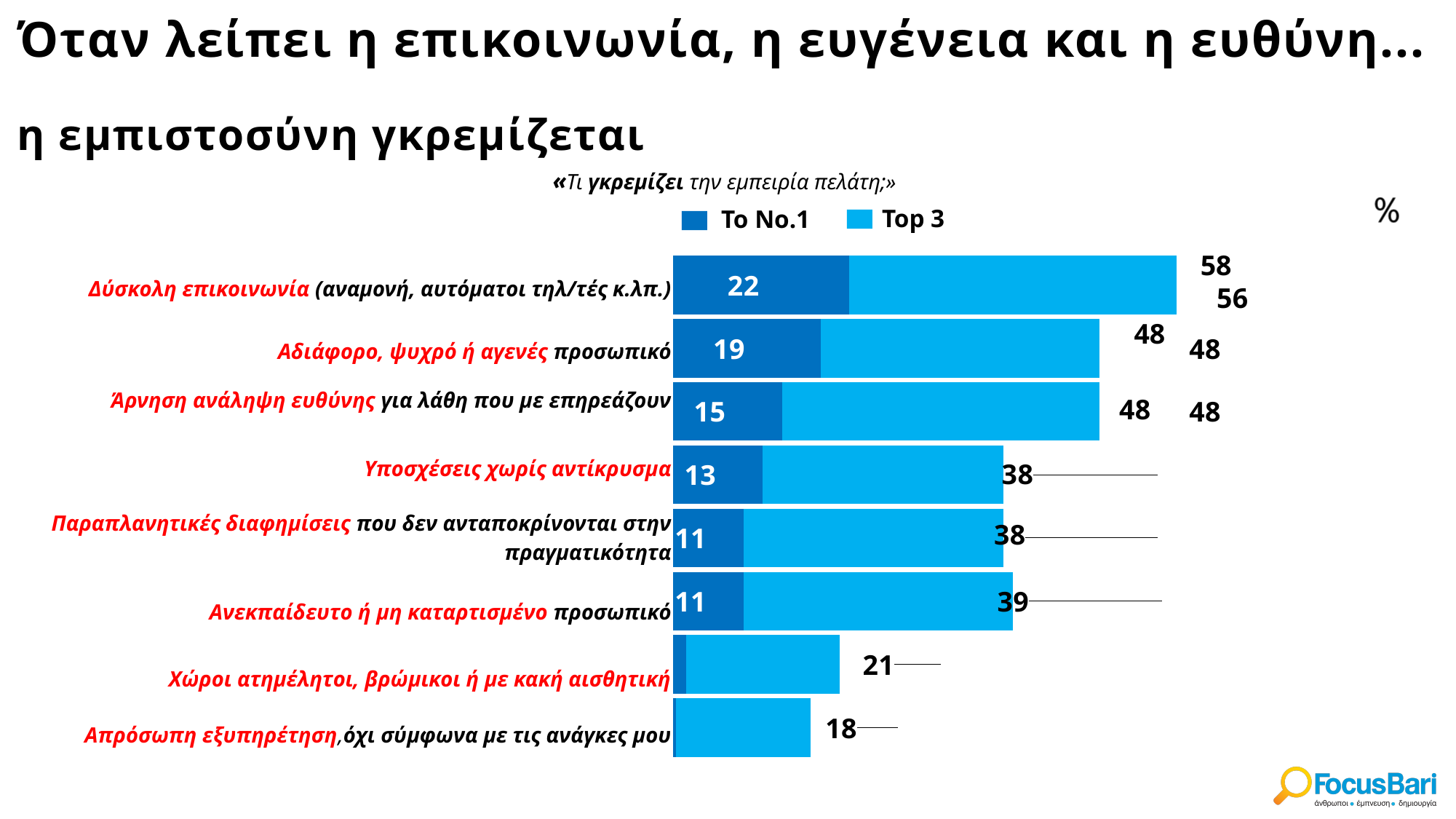
What is the 'Το No.1' value for 'Δύσκολη επικοινωνία'? 22 How many categories are plotted in the chart? 8 What kind of chart is shown on the slide? bar chart What is the 'Top 3' value for 'Ανεκπαίδευτο ή μη καταρτισμένο προσωπικό'? 39 How many series does the legend list? 2 What is the 'Top 3' value for 'Απρόσωπη εξυπηρέτηση, όχι σύμφωνα με τις ανάγκες μου'? 18 What is the 'Το No.1' value for 'Άρνηση ανάληψη ευθύνης για λάθη που με επηρεάζουν'? 15 What is the 'Το No.1' value for 'Αδιάφορο, ψυχρό ή αγενές προσωπικό'? 19 Which category has the highest 'Το No.1' value? Δύσκολη επικοινωνία (αναμονή, αυτόματοι τηλ/τές κ.λπ.) What is the difference between the 'Το No.1' values for 'Δύσκολη επικοινωνία' and 'Αδιάφορο, ψυχρό ή αγενές προσωπικό'? 3 Which category has the lowest 'Top 3' value? Απρόσωπη εξυπηρέτηση, όχι σύμφωνα με τις ανάγκες μου What is the 'Top 3' value for 'Υποσχέσεις χωρίς αντίκρυσμα'? 38